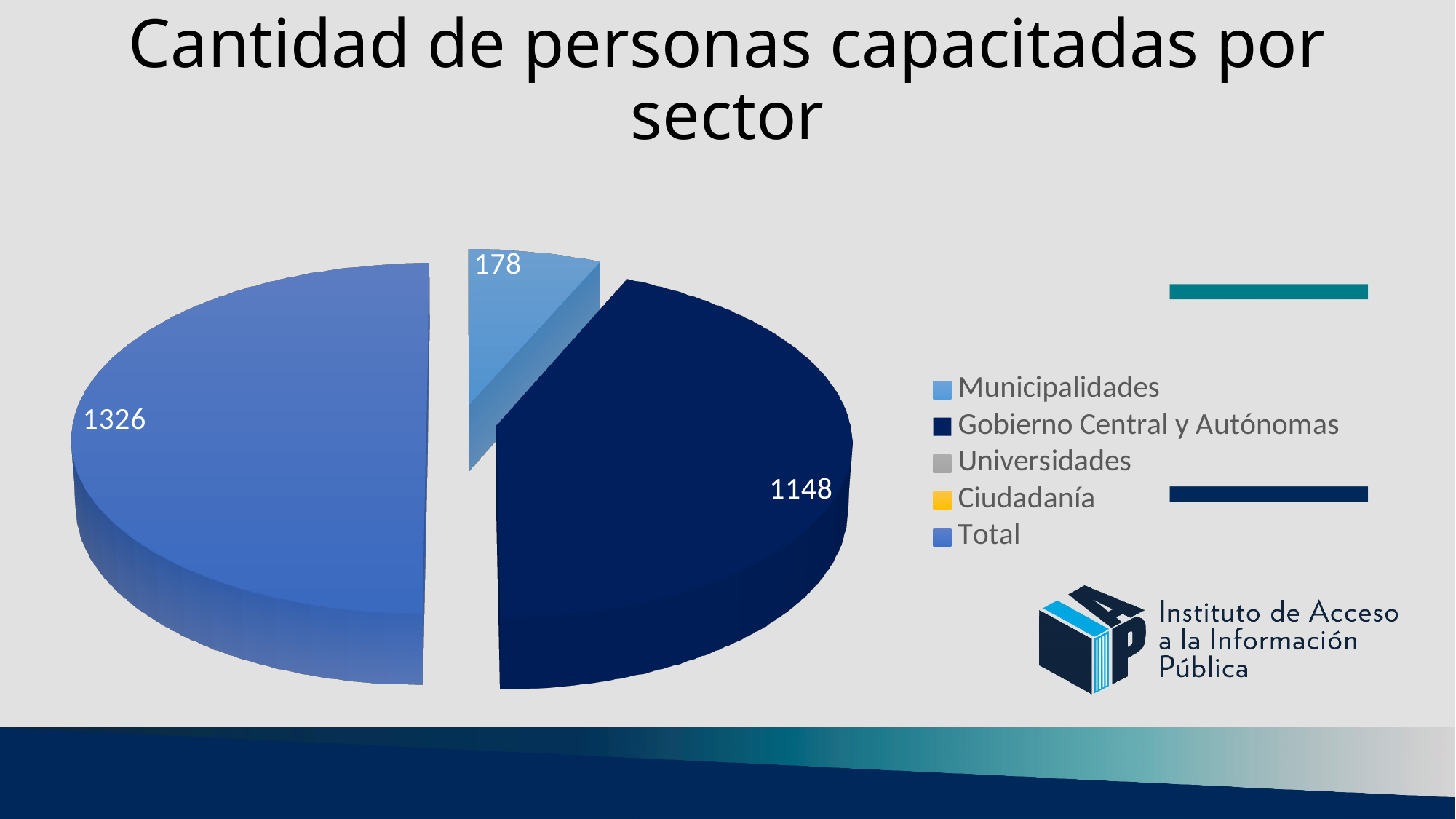
Which labelled slice has the largest value? Total What type of chart is shown on the slide? pie chart What is the value shown for Municipalidades? 178 How many entries does the legend list? 5 What is the value shown for the Total slice? 1326 What colour is the Gobierno Central y Autónomas slice? dark navy blue Which labelled slice has the smallest value? Municipalidades What is the value shown for Gobierno Central y Autónomas? 1148 What is the difference between the Total slice and the Gobierno Central y Autónomas slice? 178 Which is larger, the value for Municipalidades or the value for Gobierno Central y Autónomas? Gobierno Central y Autónomas What is the title of the chart? Cantidad de personas capacitadas por sector What is the difference between the Gobierno Central y Autónomas value and the Municipalidades value? 970